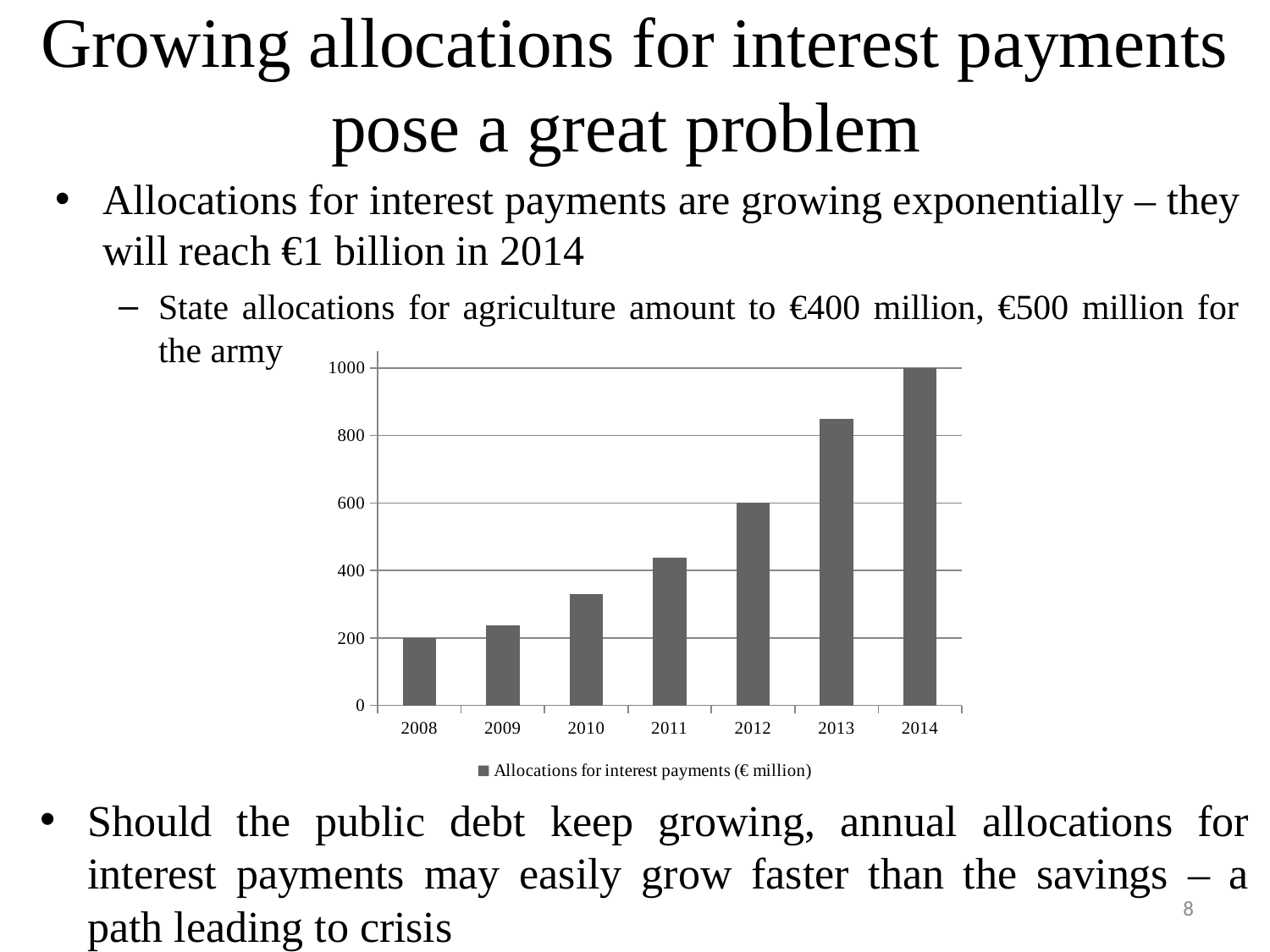
How many series does the chart legend list? 1 How many years are shown on the x axis of the chart? 7 What is the series name shown in the chart legend? Allocations for interest payments (€ million) Do the allocations for interest payments rise or fall from 2008 to 2014? Rise Which year has the lowest allocation for interest payments? 2008 What is the allocation for interest payments in 2014 (€ million)? 1000 Which year has the highest allocation for interest payments? 2014 Is the value for 2010 greater or less than 400? less Which year has a larger allocation, 2011 or 2013? 2013 What kind of chart is shown on the slide? Bar chart Is the value for 2013 greater or less than 800? greater